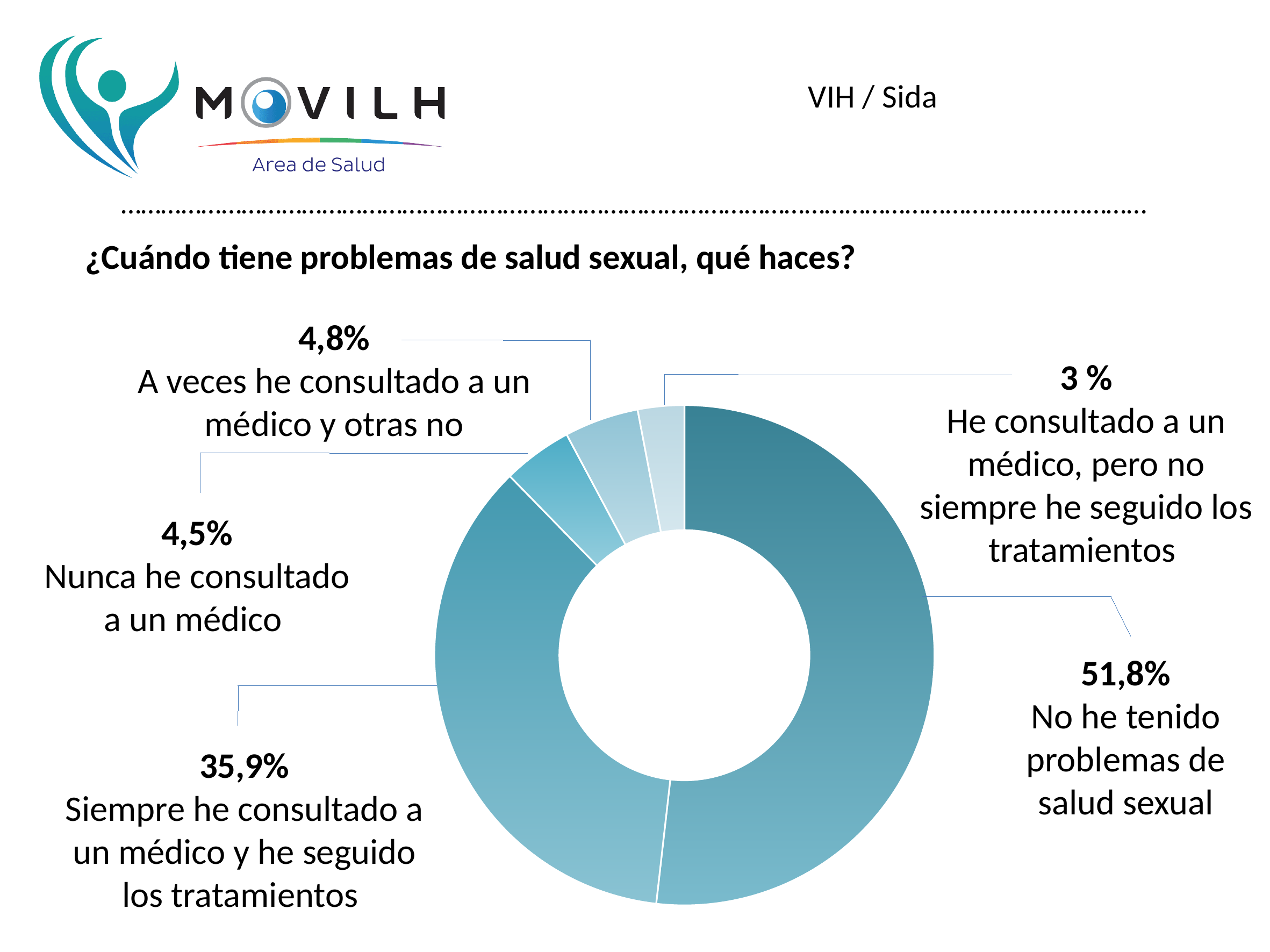
Which is larger: the share for "A veces he consultado a un médico y otras no" or for "Nunca he consultado a un médico"? A veces he consultado a un médico y otras no How many categories are shown in the chart? 5 What percentage of respondents answered "No he tenido problemas de salud sexual"? 51,8% What percentage of respondents answered "Siempre he consultado a un médico y he seguido los tratamientos"? 35,9% Which response has the largest share of the chart? No he tenido problemas de salud sexual What kind of chart is shown on the slide? Doughnut (pie) chart What question does the chart answer, according to the slide title? ¿Cuándo tiene problemas de salud sexual, qué haces? Which response has the smallest share of the chart? He consultado a un médico, pero no siempre he seguido los tratamientos What percentage of respondents answered "Nunca he consultado a un médico"? 4,5% What percentage of respondents answered "A veces he consultado a un médico y otras no"? 4,8% What percentage of respondents answered "He consultado a un médico, pero no siempre he seguido los tratamientos"? 3 % What is the difference in percentage points between "No he tenido problemas de salud sexual" and "Siempre he consultado a un médico y he seguido los tratamientos"? 15,9